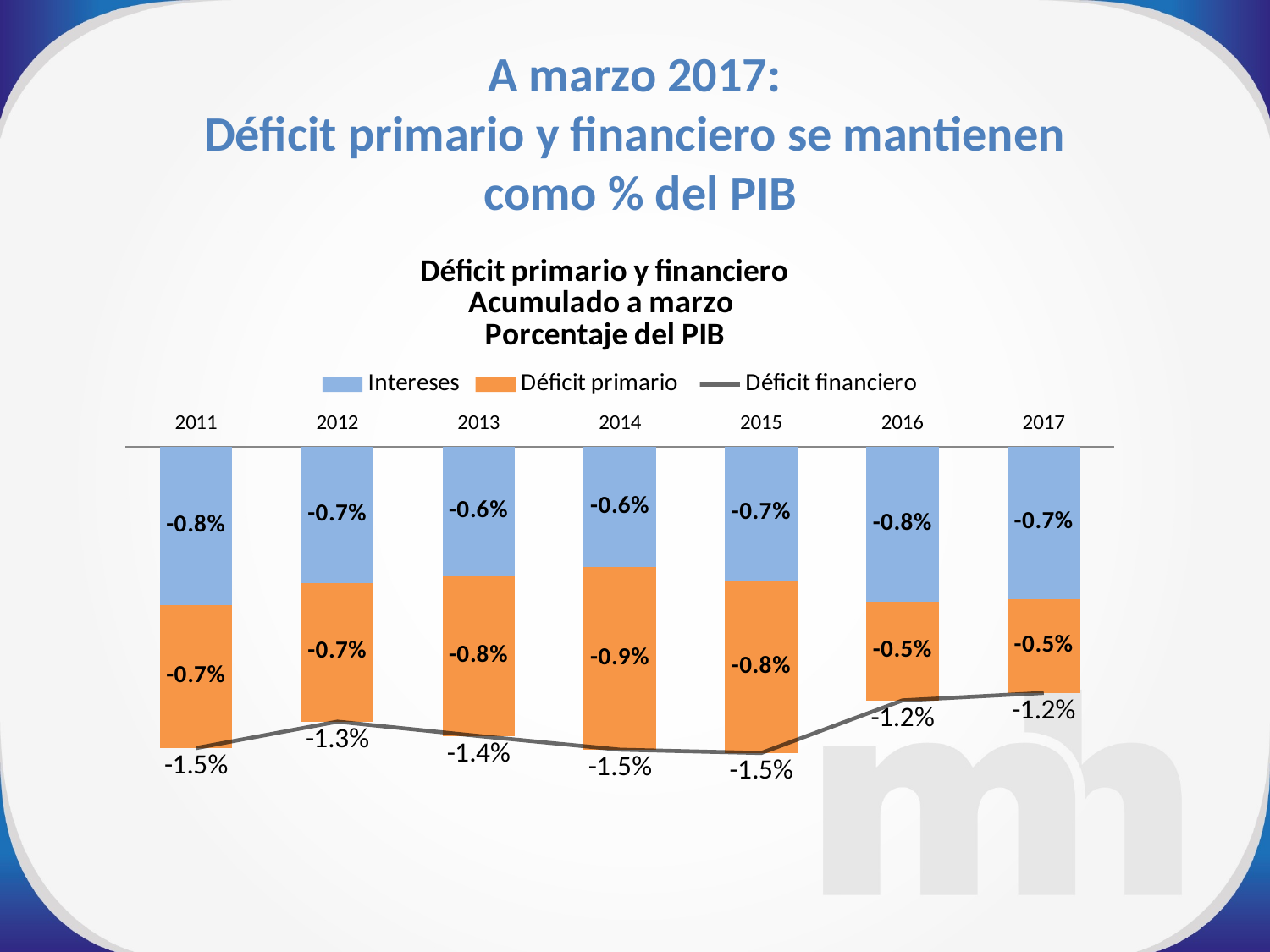
In which year is the Déficit primario value largest in magnitude (most negative)? 2014 How many years are shown on the x axis? 7 What is the value of Déficit financiero for 2012? -1.3% What is the value of Déficit primario for 2014? -0.9% What is the value of Intereses for 2011? -0.8% How many series does the legend list? 3 Which colour represents Intereses in the chart? Blue What is the difference in percentage points between the Déficit primario values for 2014 and 2017? 0.4 percentage points What is the value of Déficit primario for 2017? -0.5% Which year has a larger Déficit primario in magnitude, 2014 or 2016? 2014 What kind of chart is this? Stacked bar chart with a line What is the value of Intereses for 2015? -0.7%